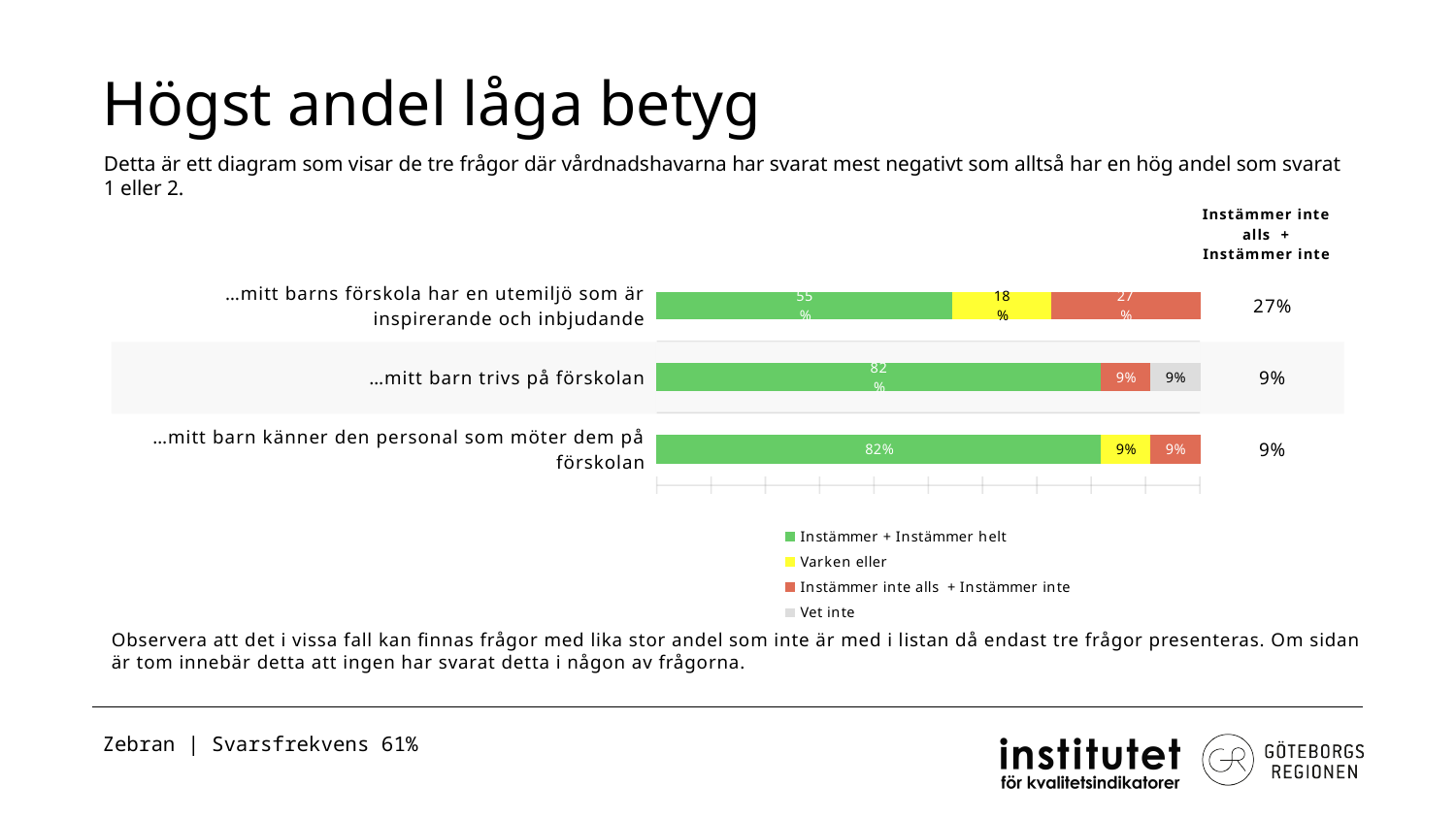
What is the title of the slide containing the chart? Högst andel låga betyg What is the value of 'Instämmer + Instämmer helt' for '…mitt barn trivs på förskolan'? 82% What is the value of 'Vet inte' for '…mitt barn trivs på förskolan'? 9% What is the value of 'Varken eller' for '…mitt barns förskola har en utemiljö som är inspirerande och inbjudande'? 18% Which category has the lowest 'Instämmer + Instämmer helt' share? …mitt barns förskola har en utemiljö som är inspirerande och inbjudande What kind of chart is shown on the slide? Stacked bar chart What is the value of 'Instämmer inte alls + Instämmer inte' for '…mitt barns förskola har en utemiljö som är inspirerande och inbjudande'? 27% Which category has the highest 'Instämmer inte alls + Instämmer inte' share? …mitt barns förskola har en utemiljö som är inspirerande och inbjudande How many categories (questions) are plotted in the chart? 3 How many series does the legend list? 4 What is the value of 'Instämmer + Instämmer helt' for '…mitt barns förskola har en utemiljö som är inspirerande och inbjudande'? 55% What is the difference between the 'Instämmer + Instämmer helt' values for '…mitt barn trivs på förskolan' and '…mitt barns förskola har en utemiljö som är inspirerande och inbjudande'? 27%